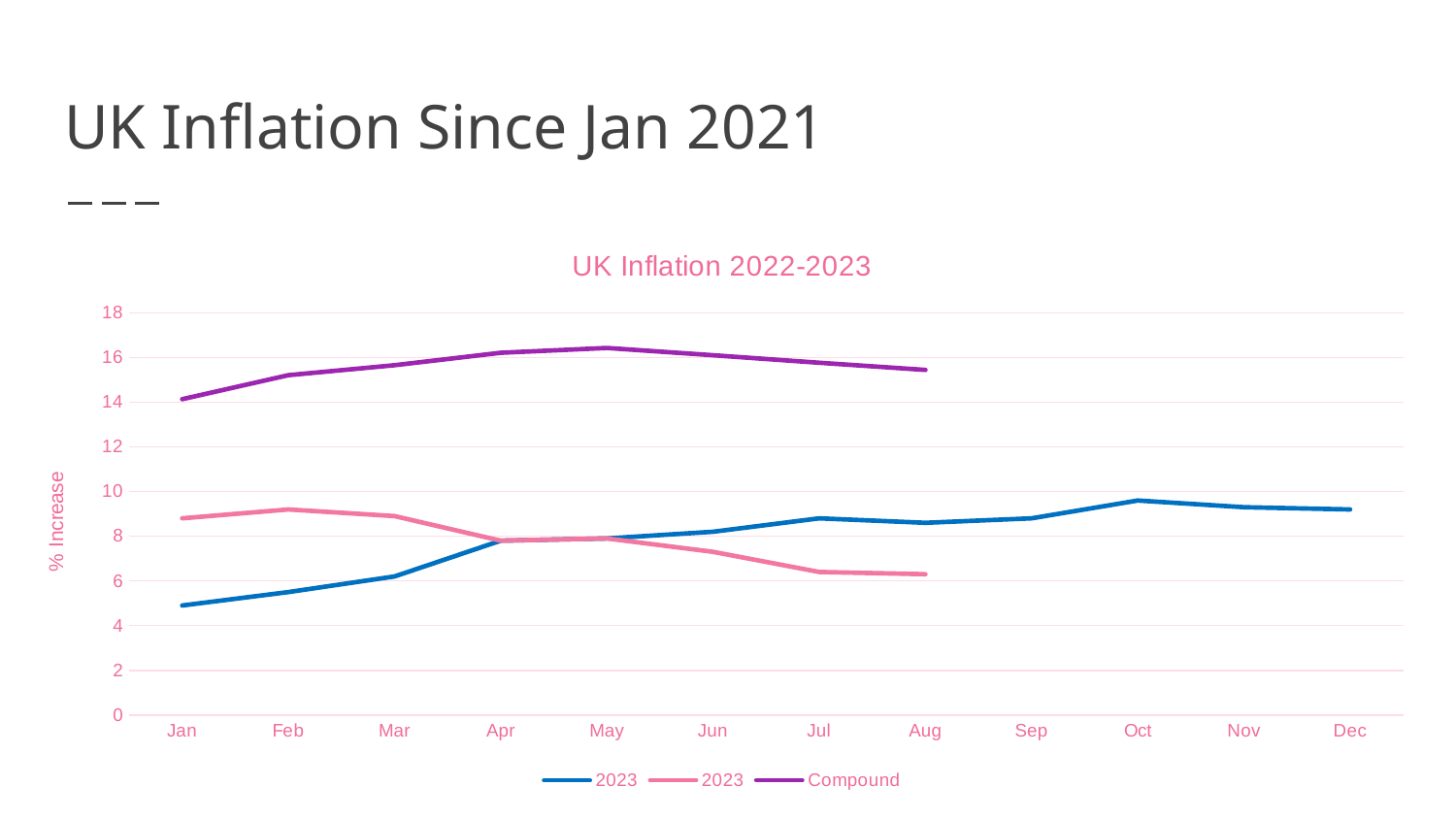
In Jan, which is higher: the blue line labelled 2023 or the pink line labelled 2023? the pink line What kind of chart is shown on the slide? line chart Is the value of the pink line labelled 2023 in Aug greater or less than 8? less Is the value of the blue line labelled 2023 in Jan greater or less than 6? less Is the value of the Compound line in May greater or less than 16? greater What is the title of the y axis? % Increase How many series does the legend list? 3 How many months are shown along the x axis? 12 Does the pink line labelled 2023 rise or fall from Feb to Aug? fall In which month does the Compound line reach its highest value? May Does the Compound line rise or fall from Jan to May? rise